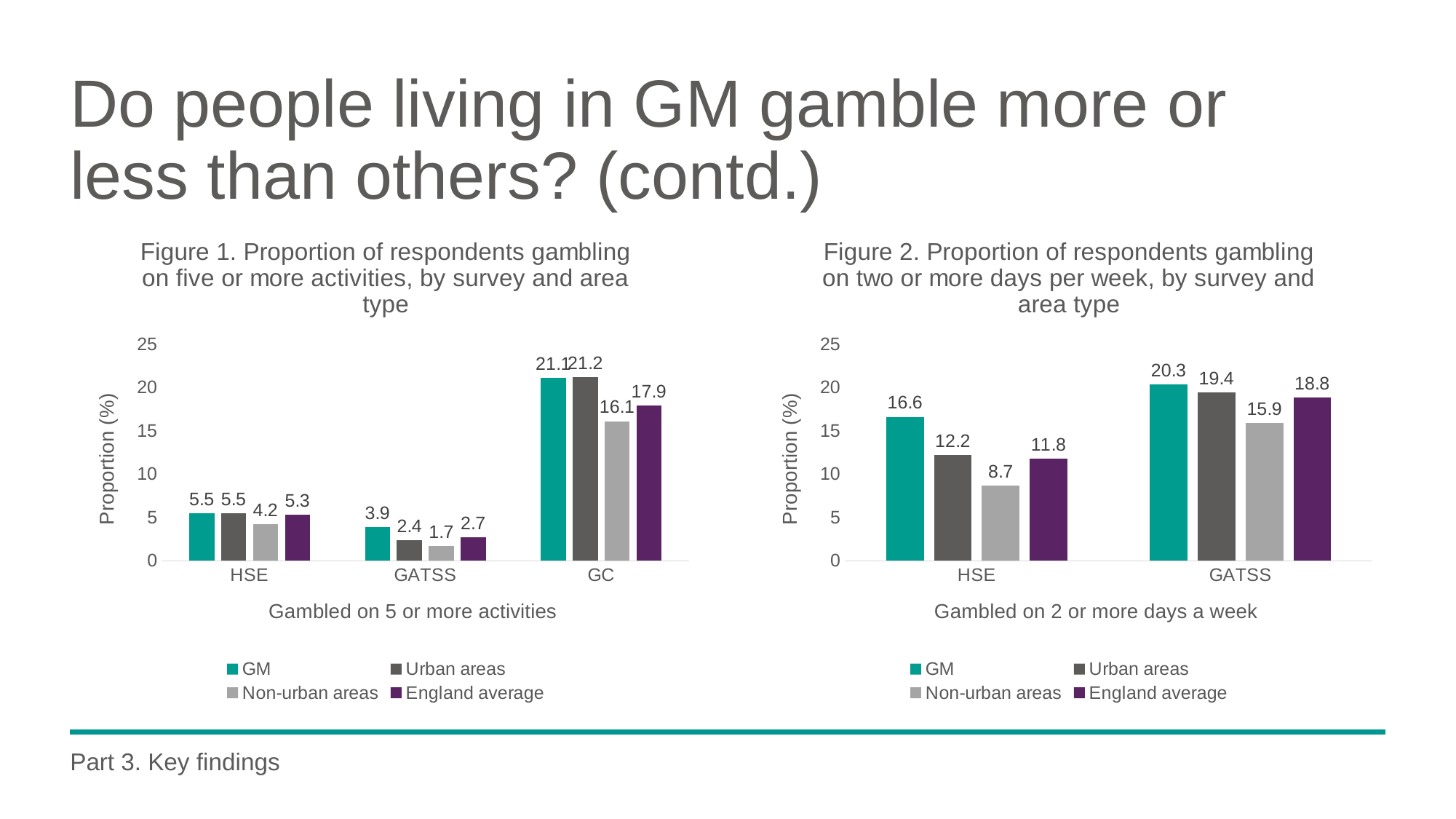
In Figure 2, which area type has the lowest value in the GATSS survey? Non-urban areas In Figure 1, how many surveys are shown on the x axis? 3 In Figure 2, how many series does the legend list? 4 In Figure 1, which survey has the highest value for GM? GC In Figure 1, what is the value for England average in the GATSS survey? 2.7 What kind of chart is Figure 1? Bar chart In Figure 1, what is the value for Non-urban areas in the GC survey? 16.1 In Figure 1, what is the difference between GM and Urban areas in the GATSS survey? 1.5 In Figure 2, what is the value for GM in the HSE survey? 16.6 In Figure 2, what is the difference between GM and Non-urban areas in the HSE survey? 7.9 In Figure 2, which is larger in the GATSS survey: Urban areas or England average? Urban areas In Figure 2, what is the y-axis label? Proportion (%)